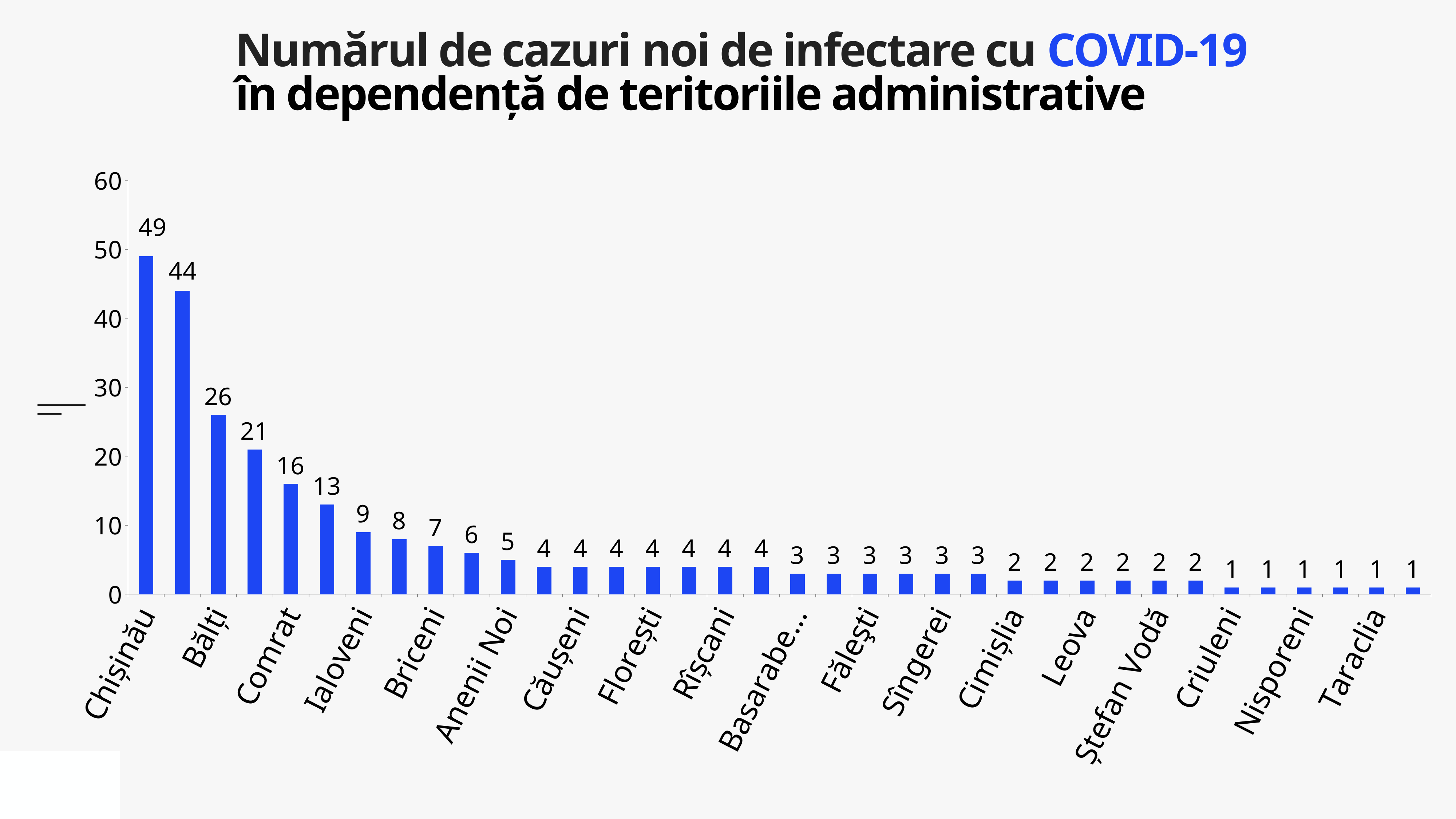
What is the number of new COVID-19 cases for Fălești? 3 Do the values rise or fall from left to right along the x axis? fall What type of chart is shown on the slide? bar chart How many bars are plotted in the chart? 36 What is the number of new COVID-19 cases for Leova? 2 What is the number of new COVID-19 cases for Chișinău? 49 Which territory has the highest number of new cases? Chișinău What is the number of new COVID-19 cases for Bălți? 26 What is the difference between the number of new cases in Chișinău and in Taraclia? 48 Is the value for Chișinău greater or less than 40? greater Which has more new cases, Chișinău or Bălți? Chișinău What is the number of new COVID-19 cases for Taraclia? 1